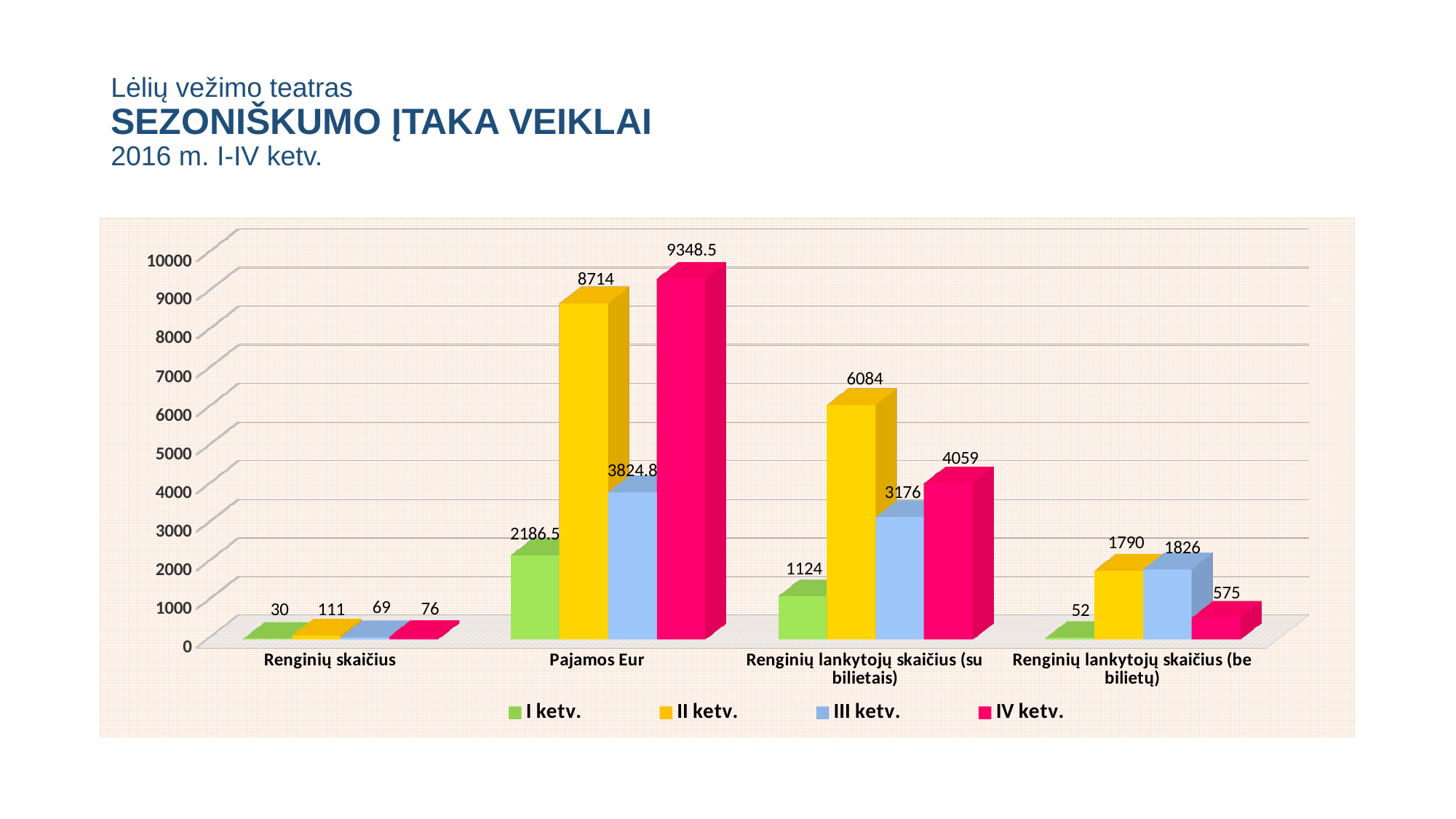
How many series does the legend list? 4 What is the value for I ketv. in the Renginių skaičius category? 30 Which quarter has the highest value in the Pajamos Eur category? IV ketv. What is the difference between the II ketv. and I ketv. values in the Renginių skaičius category? 81 In the Renginių lankytojų skaičius (be bilietų) category, which is larger: II ketv. or IV ketv.? II ketv. What is the difference between the IV ketv. and II ketv. values in the Pajamos Eur category? 634.5 How many categories are shown on the x axis? 4 What is the value for IV ketv. in the Renginių lankytojų skaičius (be bilietų) category? 575 What is the value for III ketv. in the Renginių lankytojų skaičius (su bilietais) category? 3176 What kind of chart is shown on the slide? Bar chart What is the value for II ketv. in the Pajamos Eur category? 8714 Which quarter has the lowest value in the Renginių lankytojų skaičius (su bilietais) category? I ketv.